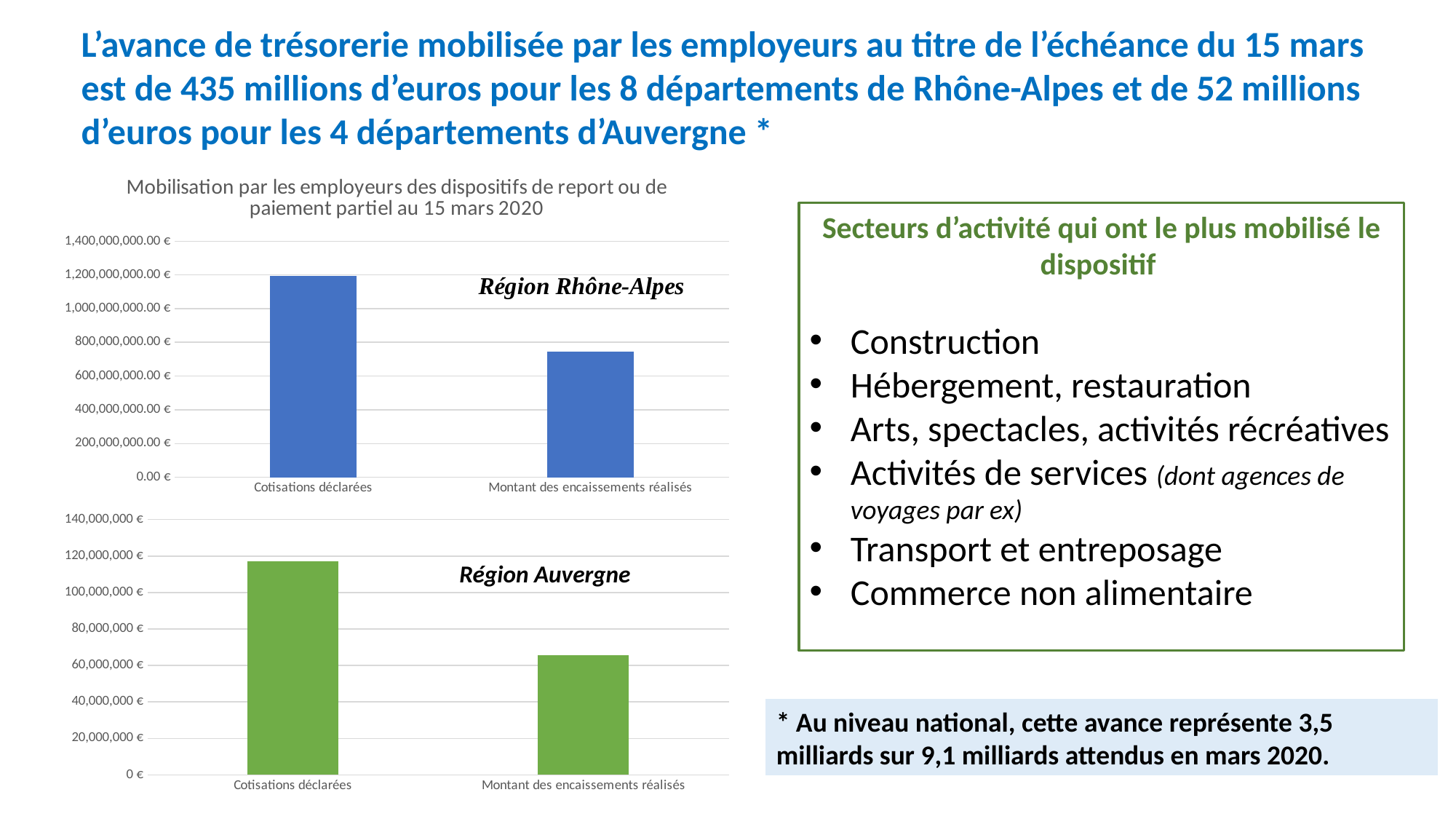
In the Région Rhône-Alpes chart, which category has the lowest value? Montant des encaissements réalisés What colour are the bars in the Région Auvergne chart? Green In the Région Auvergne chart, is the value for Montant des encaissements réalisés greater or less than 80,000,000 €? less In the Région Auvergne chart, which is larger: Cotisations déclarées or Montant des encaissements réalisés? Cotisations déclarées In the Région Rhône-Alpes chart, is the value for Cotisations déclarées greater or less than 1,000,000,000.00 €? greater How many categories are shown in the Région Rhône-Alpes chart? 2 In the Région Rhône-Alpes chart, is the value for Montant des encaissements réalisés greater or less than 800,000,000.00 €? less In the Région Auvergne chart, which category has the highest value? Cotisations déclarées What kind of chart is the Région Rhône-Alpes chart? Bar chart In the Région Rhône-Alpes chart, which category has the highest value? Cotisations déclarées What is the title of the top chart on the slide? Mobilisation par les employeurs des dispositifs de report ou de paiement partiel au 15 mars 2020